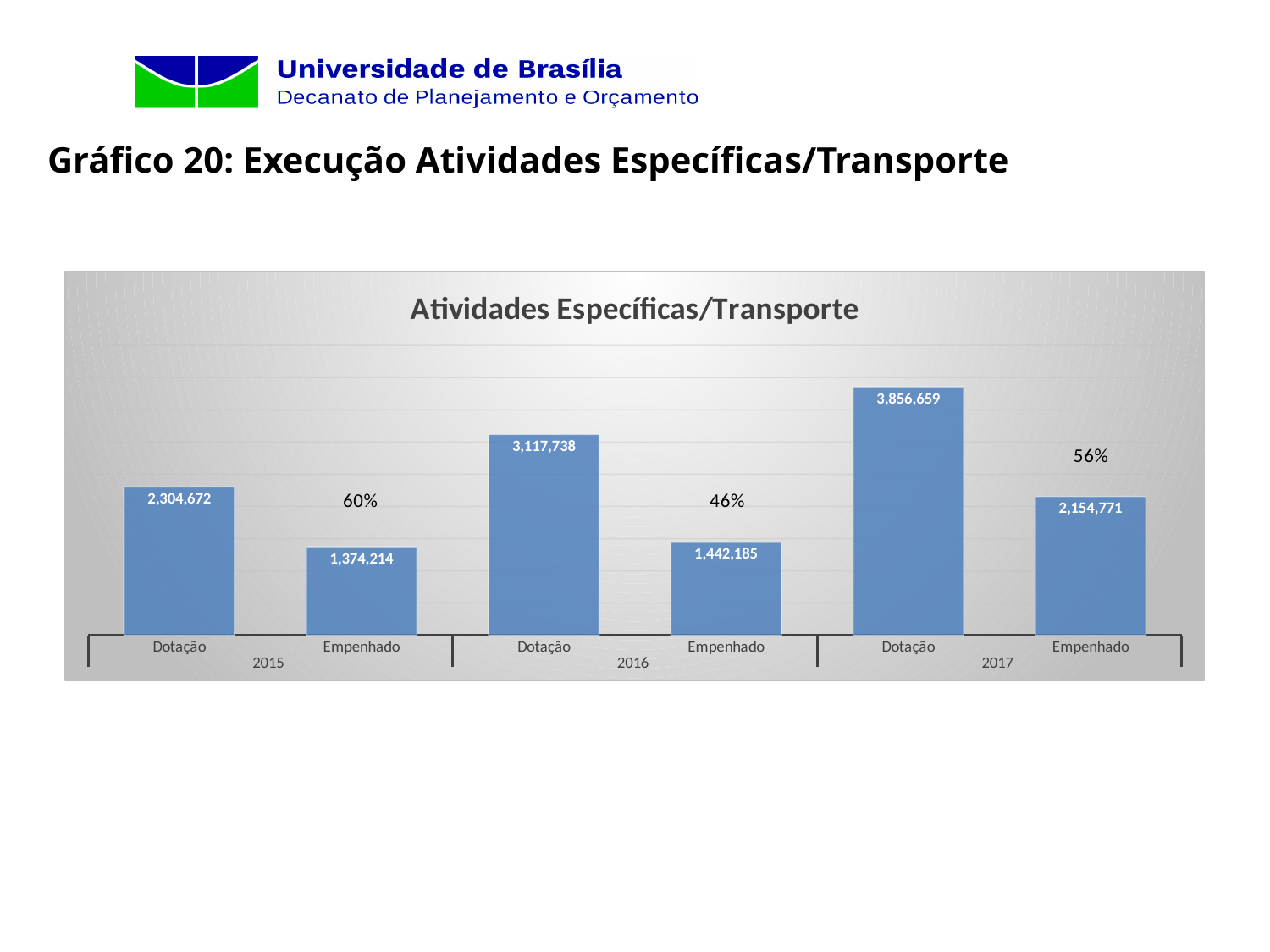
What is the value of Empenhado for 2016? 1,442,185 What type of chart is shown? Bar chart Which bar has the highest value? Dotação 2017 What is the difference between Dotação and Empenhado in 2016? 1,675,553 What percentage is shown above the Empenhado bar for 2017? 56% Which is larger, Empenhado in 2017 or Dotação in 2015? Dotação in 2015 What is the value of Dotação for 2015? 2,304,672 What is the value of Dotação for 2017? 3,856,659 Which bar has the lowest value? Empenhado 2015 What percentage is shown above the Empenhado bar for 2015? 60% What is the title of the chart? Atividades Específicas/Transporte How many bars are plotted in the chart? 6